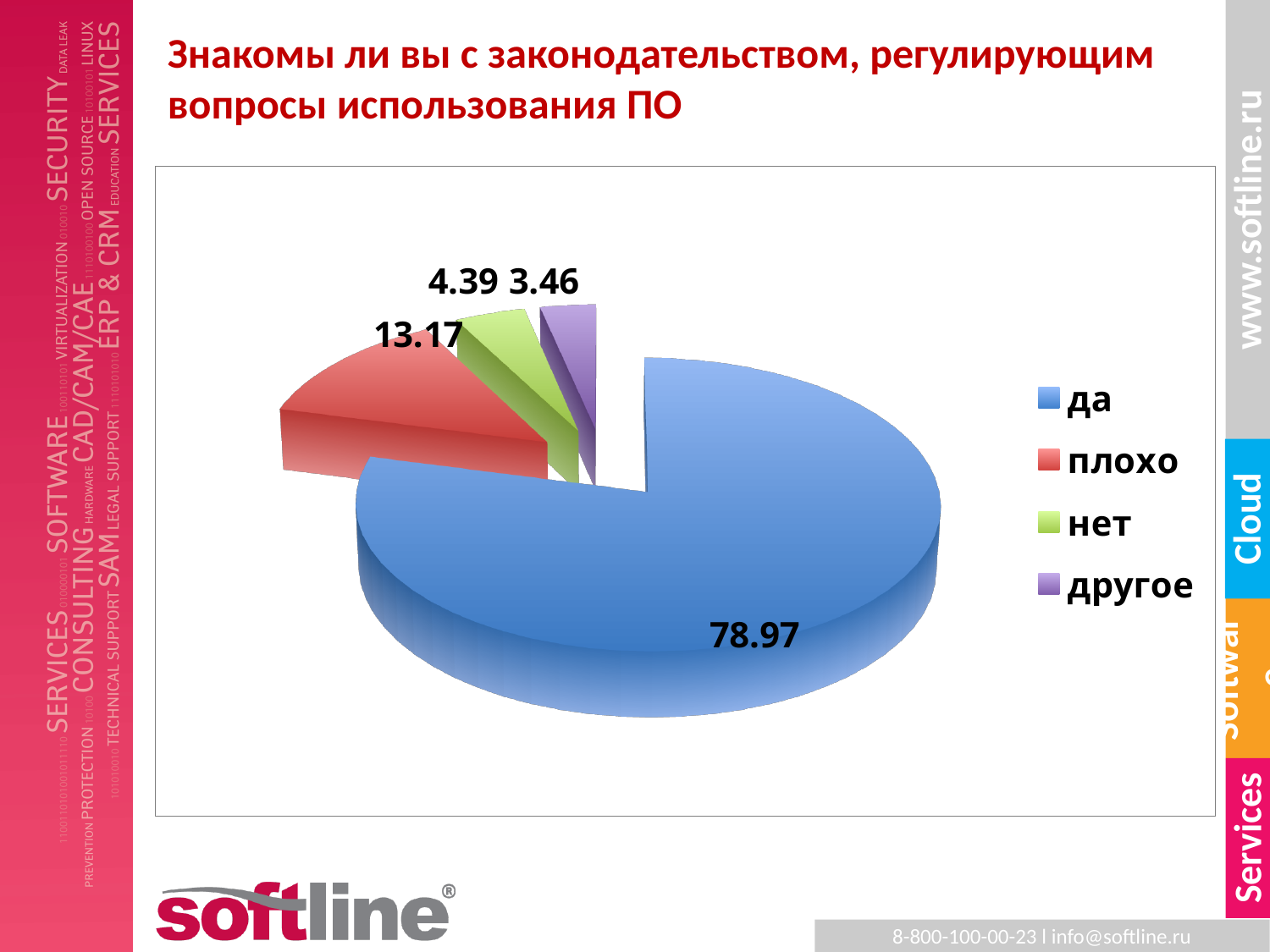
Which category has the largest slice? да What colour is the "плохо" slice? red What is the value for the "плохо" slice? 13.17 What is the value for the "да" slice? 78.97 What is the value for the "нет" slice? 4.39 How many slices does the pie chart have? 4 Which category has the smallest slice? другое How many entries does the legend list? 4 What kind of chart is shown on the slide? pie chart Which is larger, the value for "нет" or the value for "другое"? нет What is the difference between the values for "да" and "плохо"? 65.8 What is the value for the "другое" slice? 3.46